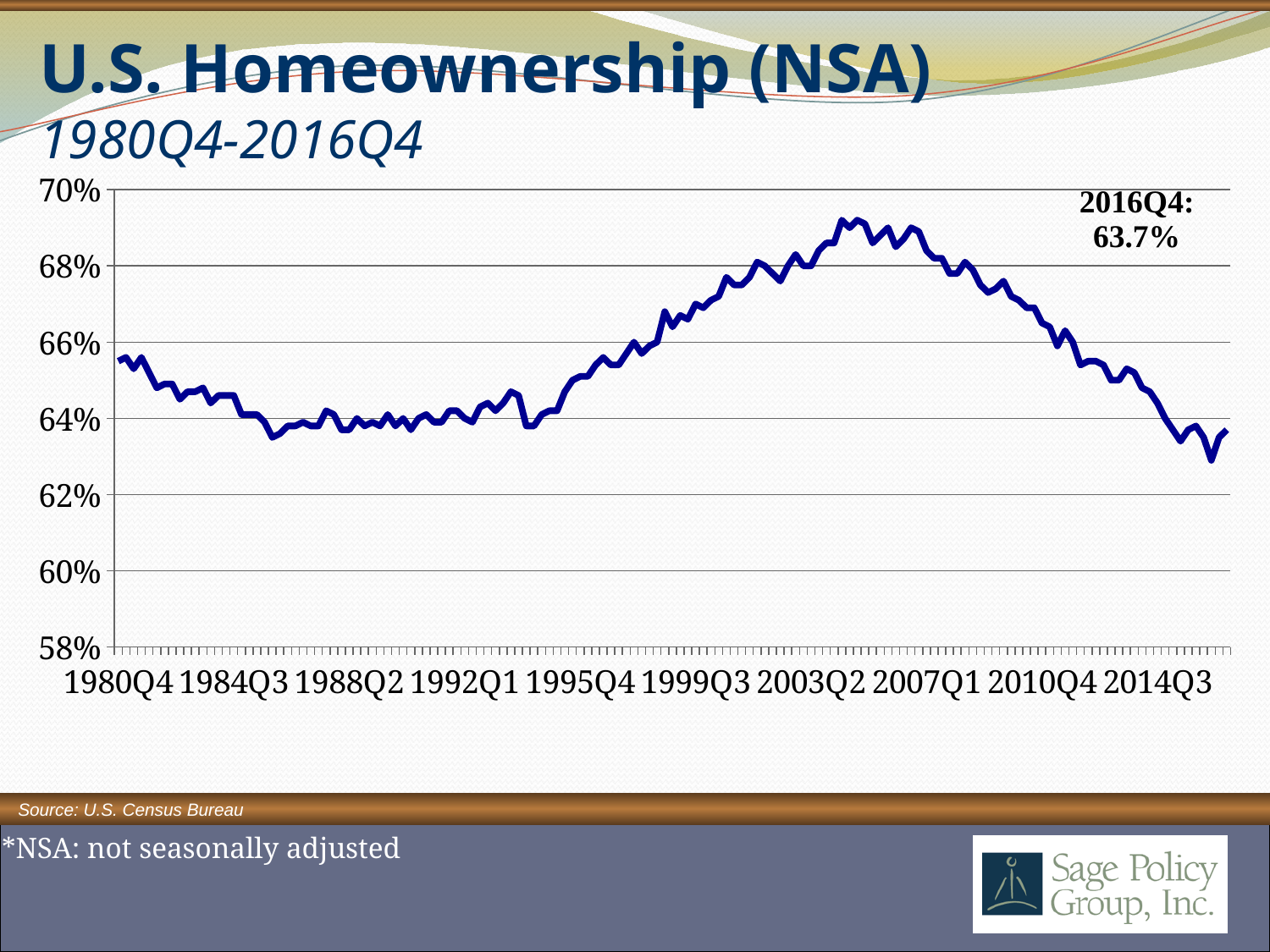
Does the homeownership rate rise or fall between 2007Q1 and 2016Q4? fall Is the homeownership rate at 2007Q1 greater or less than 68%? greater What is the title of the chart on the slide? U.S. Homeownership (NSA) 1980Q4-2016Q4 Does the homeownership rate rise or fall between 1995Q4 and 2003Q2? rise Is the homeownership rate at 2014Q3 greater or less than 66%? less Is the homeownership rate at 2003Q2 greater or less than 66%? greater What source is cited for the chart data? U.S. Census Bureau What kind of chart is shown on the slide? line chart What is the U.S. homeownership rate shown for 2016Q4? 63.7% How many lines are plotted on the chart? 1